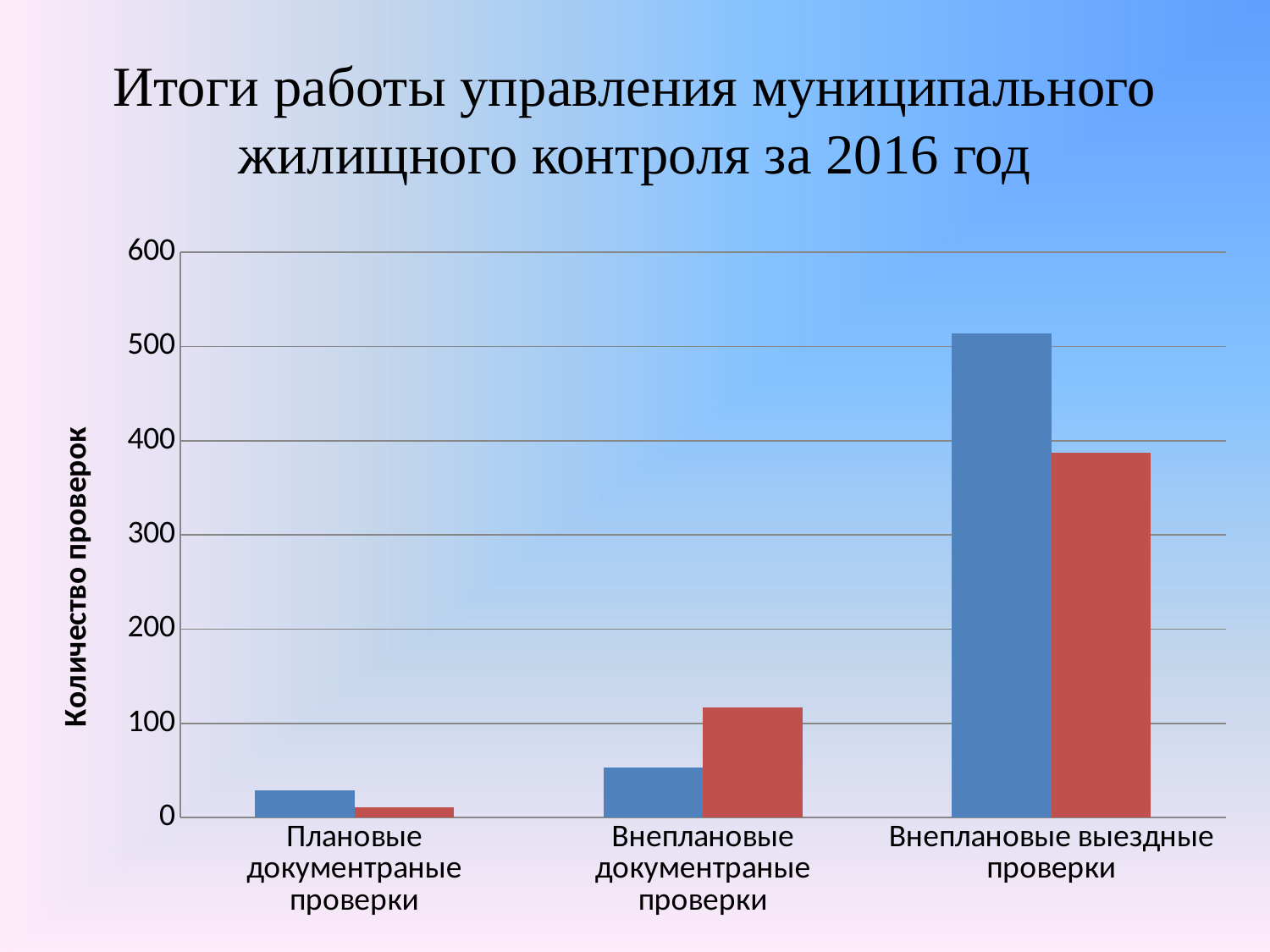
How many categories are shown on the x axis of the chart? 3 Do the blue bars rise or fall from left to right across the categories? rise Is the blue bar for Внеплановые выездные проверки greater or less than 500? greater Which category has the shortest red bar? Плановые документраные проверки What kind of chart is shown on the slide? bar chart For Внеплановые выездные проверки, which bar is taller, the blue one or the red one? the blue one What is the label of the vertical axis of the chart? Количество проверок Is the red bar for Внеплановые выездные проверки greater or less than 400? less Is the red bar for Внеплановые документраные проверки greater or less than 100? greater Which category has the tallest blue bar? Внеплановые выездные проверки For Внеплановые документраные проверки, which bar is taller, the blue one or the red one? the red one